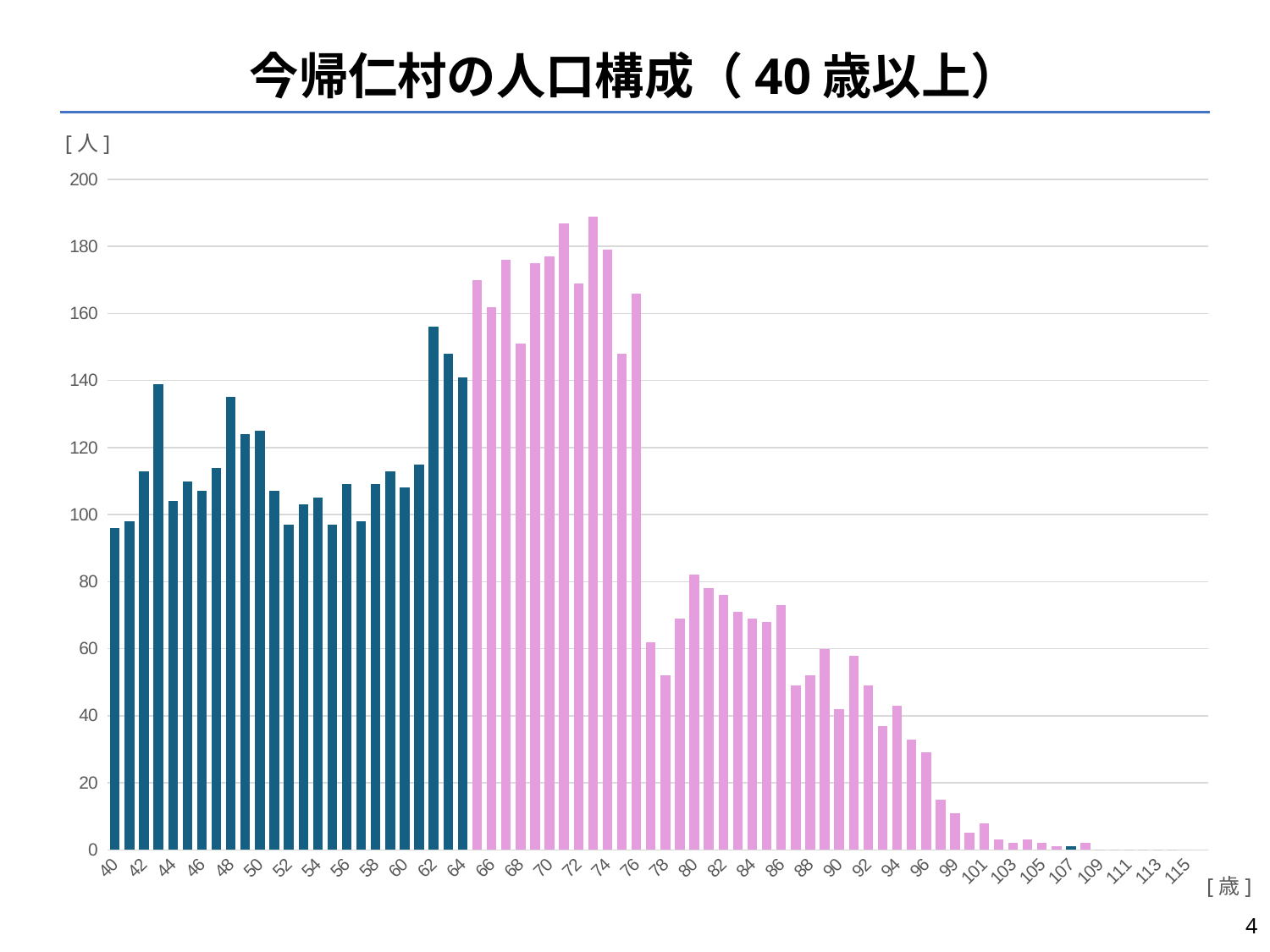
Is the value for age 62 greater or less than 140? greater Is the value for age 48 greater or less than 120? greater Which is larger, the value for age 62 or the value for age 40? age 62 Is the value for age 65 greater or less than 160? greater What kind of chart is shown on the slide? bar chart What unit is shown on the vertical axis of the chart? [人] Which is larger, the value for age 80 or the value for age 90? age 80 What is the title of the chart? 今帰仁村の人口構成（40歳以上） From age 80 onward, do the values generally rise or fall as age increases? fall